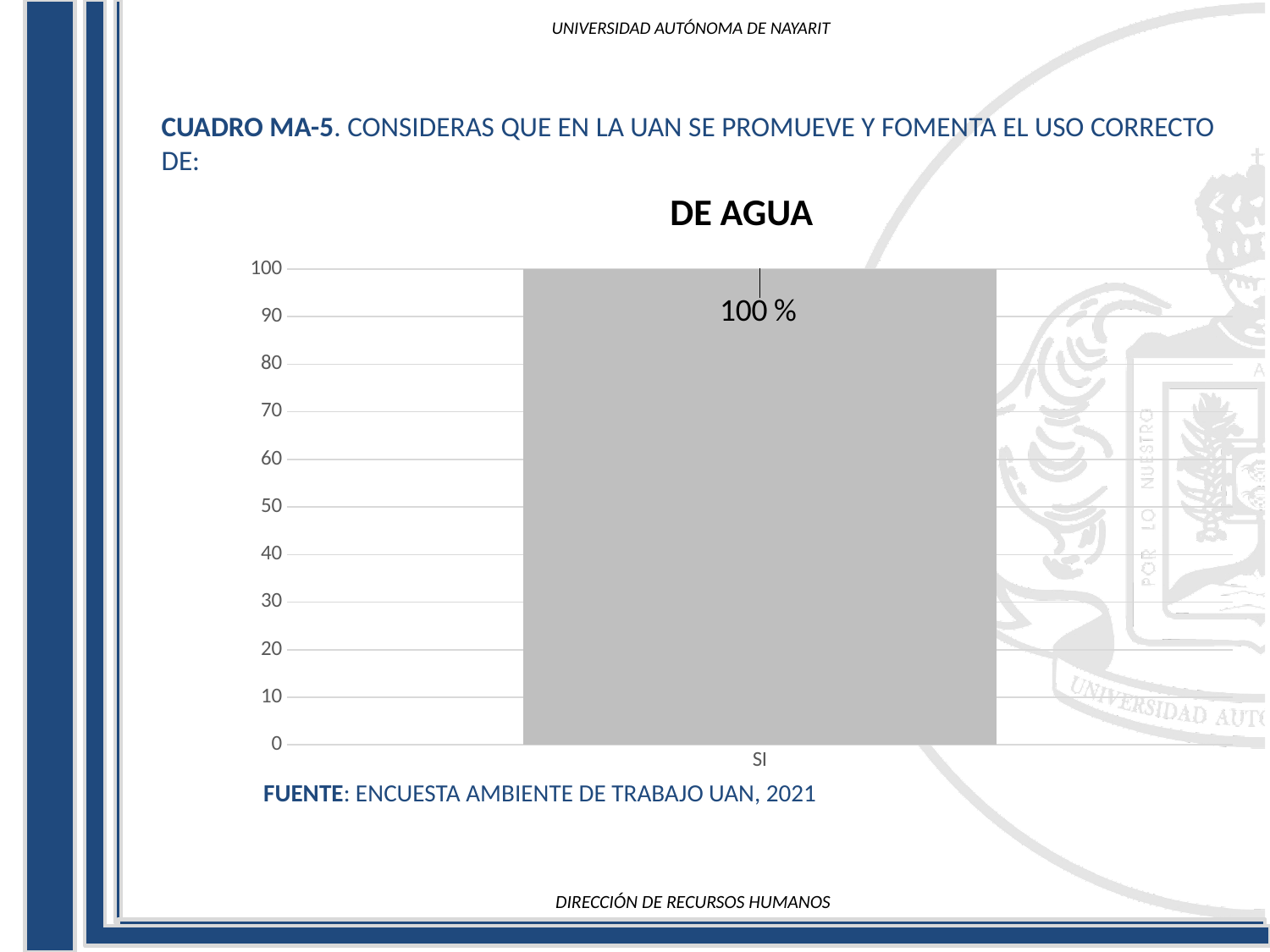
Is the value for SI greater or less than 50? greater What is the title of the chart? DE AGUA What is the label of the only category on the x axis? SI What is the value for the SI category? 100 % What is the highest value shown on the y axis? 100 How many categories are plotted on the x axis? 1 What kind of chart is shown on the slide? bar chart